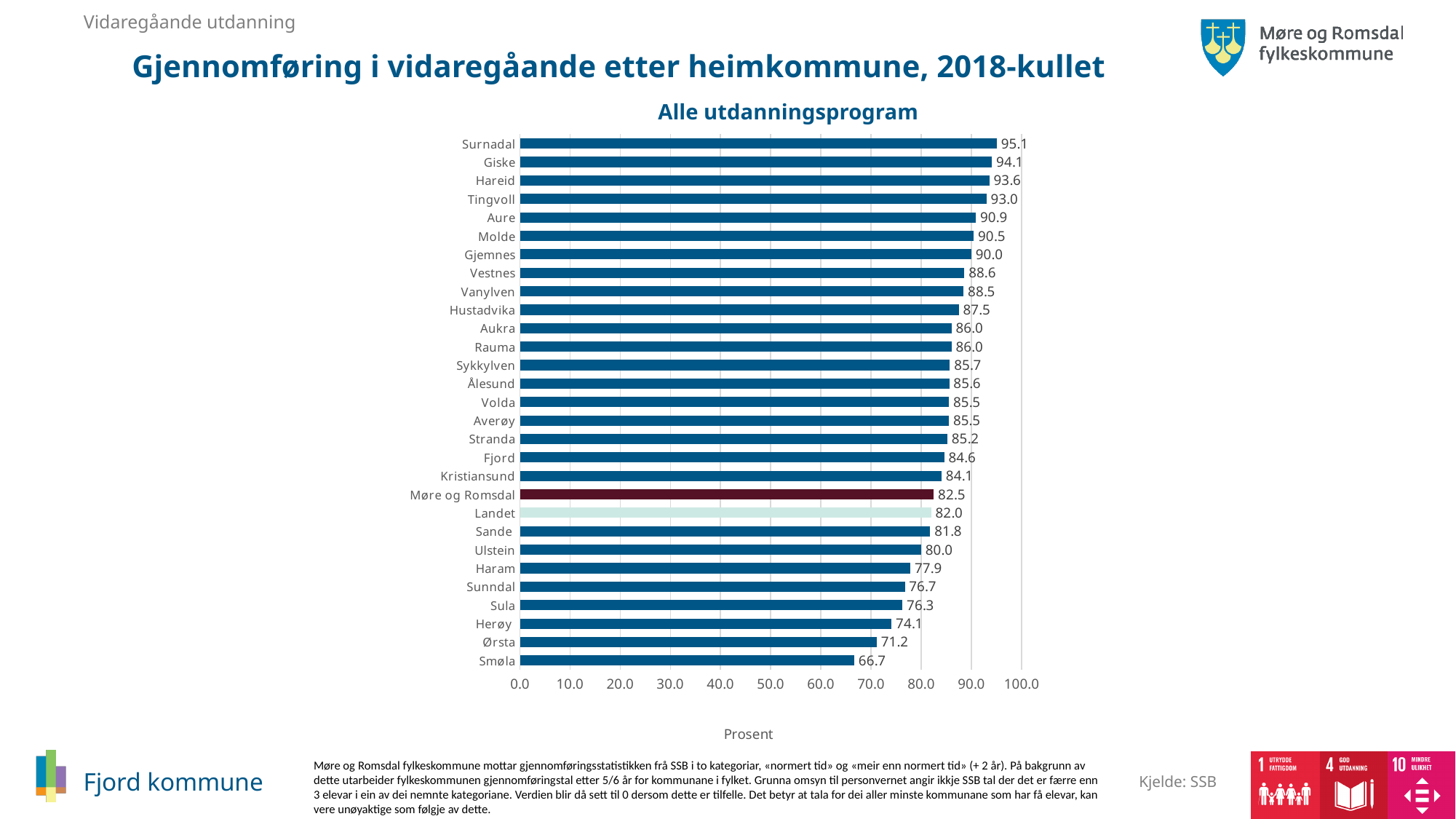
What is the value for Fjord? 84.6 Which category has the lowest value? Smøla Which category has the highest value? Surnadal What is the difference between the values for Fjord and Landet? 2.6 Which is larger, the value for Molde or the value for Ålesund? Molde How many categories are shown in the chart? 29 What is the title of the chart? Alle utdanningsprogram What kind of chart is shown on the slide? Bar chart What is the difference between the values for Surnadal and Smøla? 28.4 Is the value for Ørsta greater or less than 80.0? less What is the value for Møre og Romsdal? 82.5 What is the value for Landet? 82.0